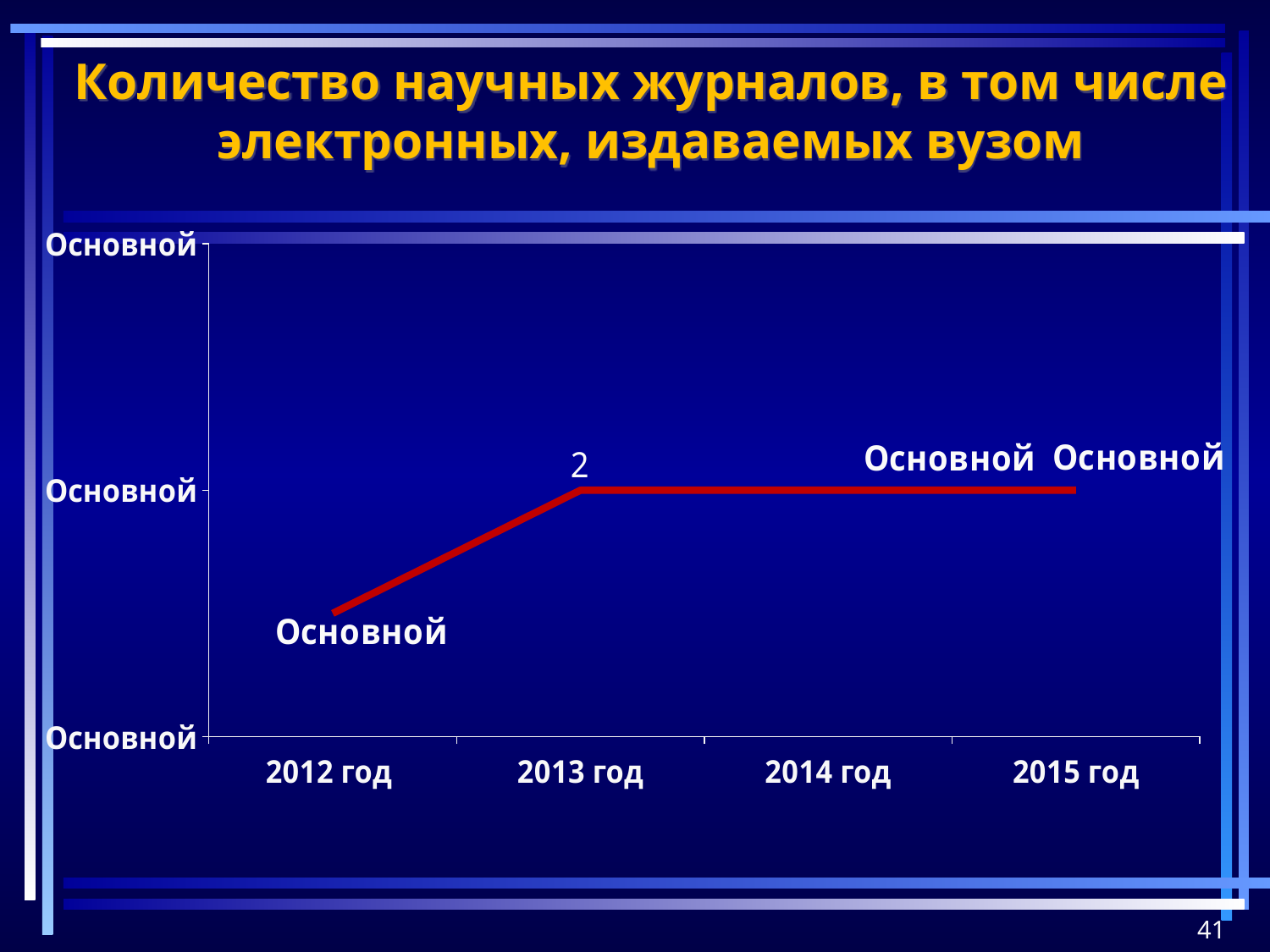
What value is labelled on the line for 2013 год? 2 What colour is the plotted line? red How many data points are plotted on the line? 4 Which year has the lowest value on the line? 2012 год What is the last category on the x axis? 2015 год How does the line change from 2012 год to 2013 год? rises What is the title of the chart on the slide? Количество научных журналов, в том числе электронных, издаваемых вузом What kind of chart is shown on the slide? line chart What is the first category on the x axis? 2012 год Which is larger, the value for 2012 год or the value for 2015 год? 2015 год Which is larger, the value for 2012 год or the value for 2013 год? 2013 год How does the line change from 2013 год to 2015 год? stays flat